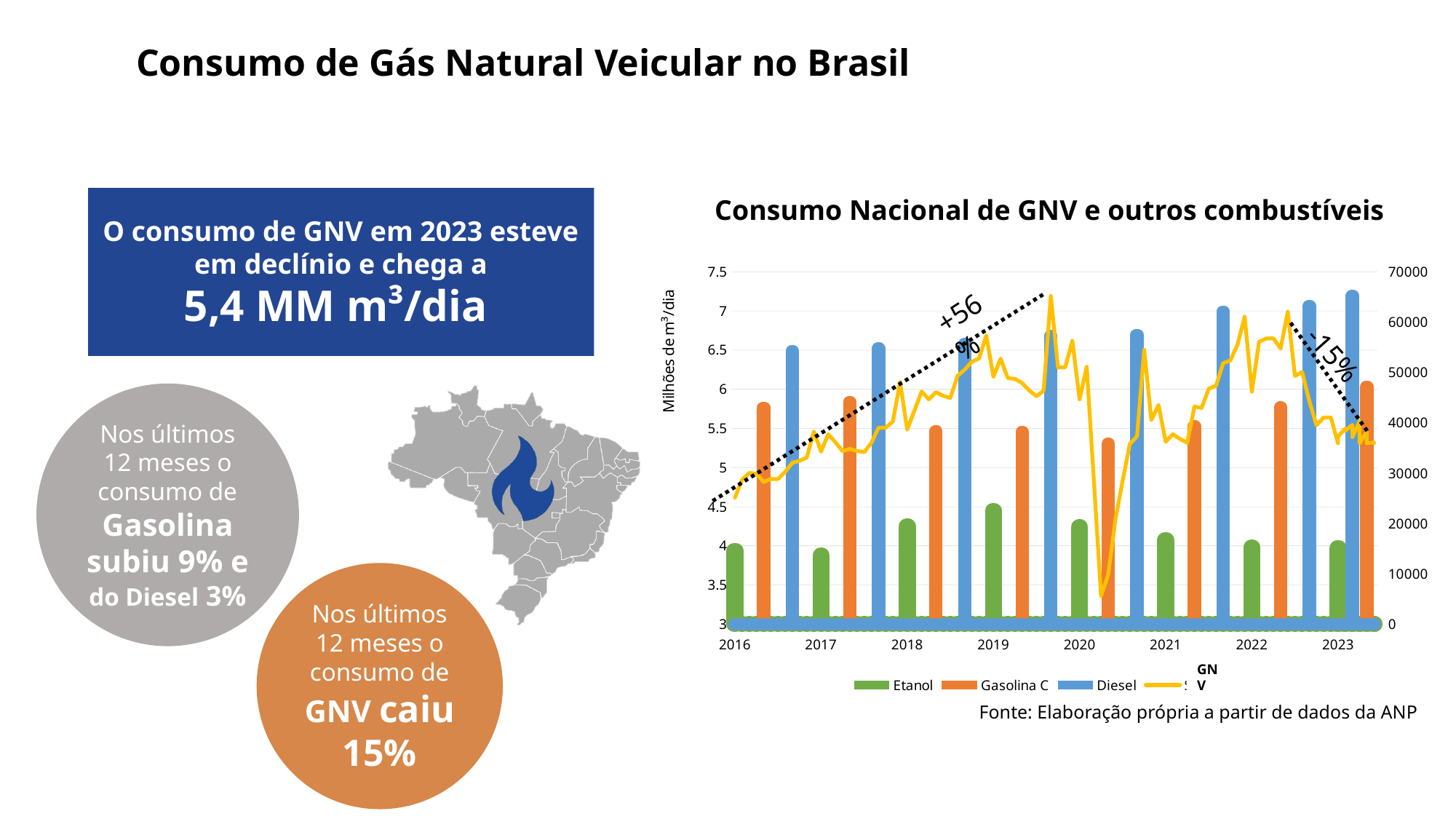
What is the label of the left vertical axis of the chart? Milhões de m³/dia Which series in the chart is drawn as a line rather than bars? GNV How many series does the legend of the chart list? 4 Do the Diesel bars generally rise or fall from 2016 to 2023? Rise In which year is the Gasolina C bar the lowest? 2020 In which year is the Etanol bar the highest? 2019 What kind of chart is 'Consumo Nacional de GNV e outros combustíveis'? A combined bar and line chart How many years are labelled on the x axis of the chart? 8 In 2022, which is larger, the Diesel bar or the Etanol bar? Diesel In which year is the Diesel bar the highest? 2023